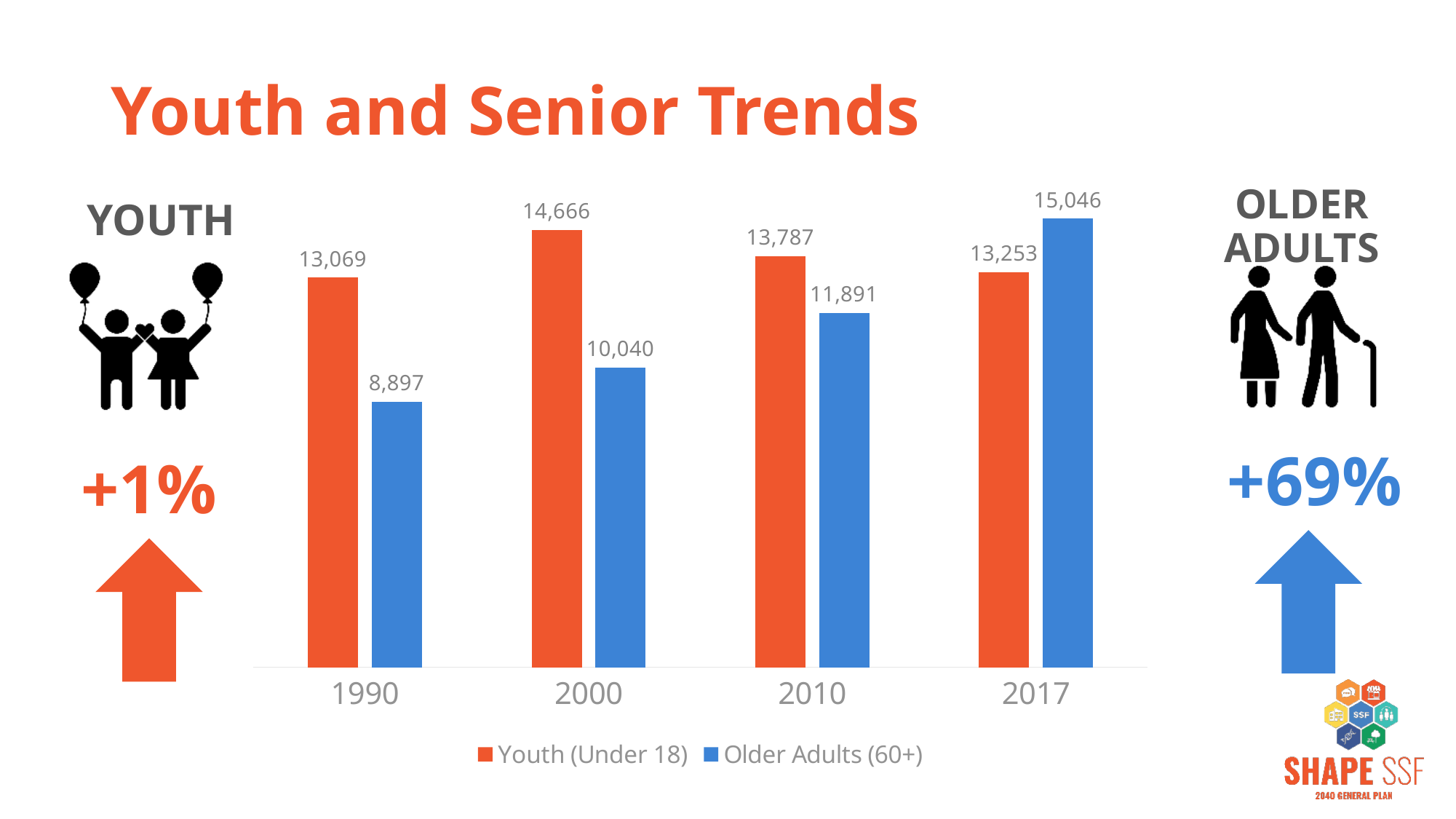
How many years are shown on the x axis? 4 Which is larger in 2017, Youth (Under 18) or Older Adults (60+)? Older Adults (60+) Do the Older Adults (60+) values rise or fall from 1990 to 2017? Rise How many series does the legend list? 2 What colour are the Older Adults (60+) bars? Blue What is the value for Older Adults (60+) in 2000? 10,040 What is the difference between the Youth (Under 18) and Older Adults (60+) values in 1990? 4,172 In which year is the Older Adults (60+) value lowest? 1990 In which year is the Youth (Under 18) value highest? 2000 What kind of chart is shown on the slide? Bar chart What is the value for Youth (Under 18) in 1990? 13,069 What is the value for Older Adults (60+) in 2017? 15,046